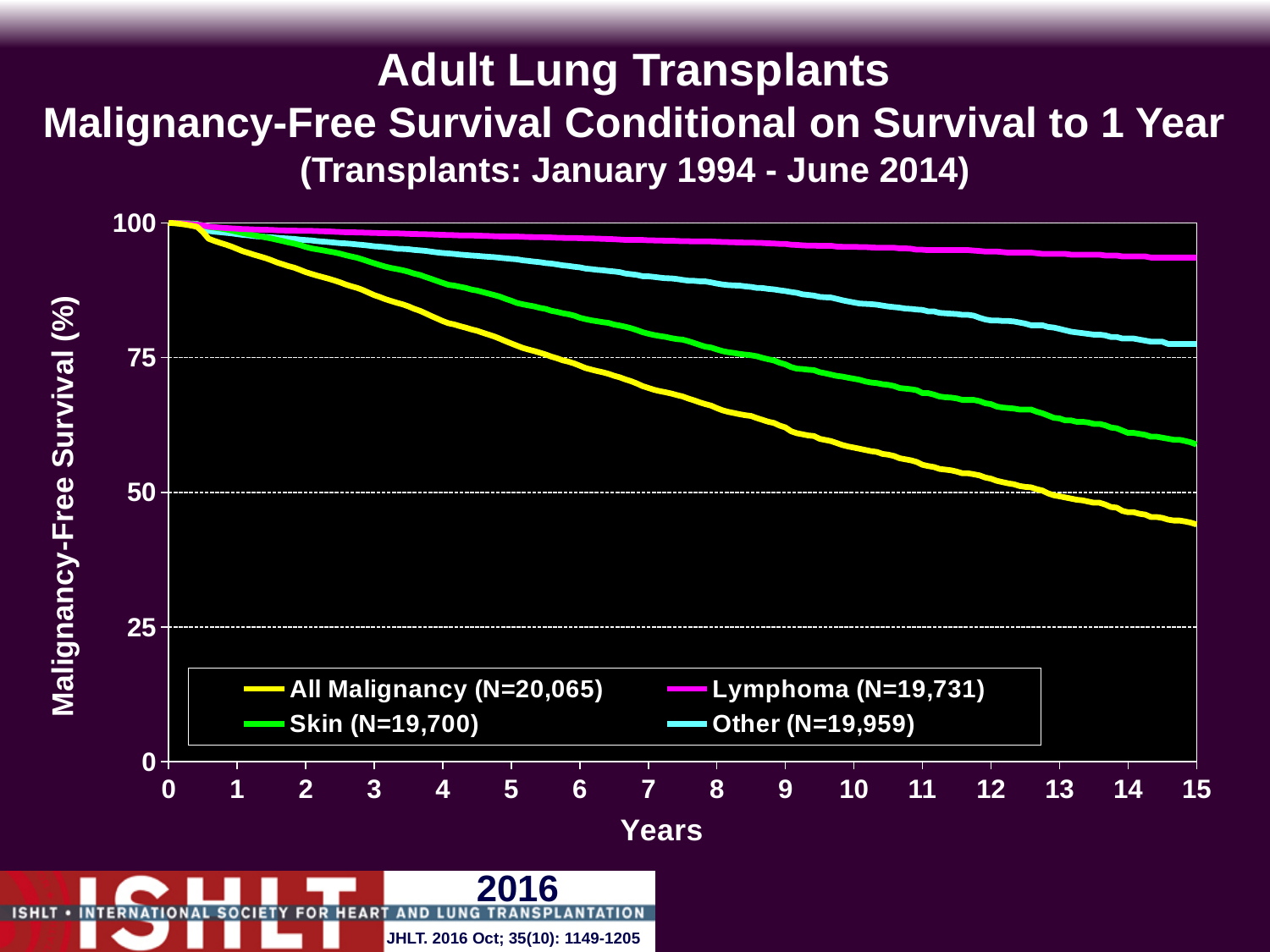
How many series does the legend list? 4 Which series has the lowest malignancy-free survival at 15 years? All Malignancy What colour is the All Malignancy line? yellow Is the value for Lymphoma at 15 years greater or less than 75? greater Which series has the highest malignancy-free survival at 15 years? Lymphoma What is the N shown in the legend for the Lymphoma series? 19,731 Does the All Malignancy curve rise or fall as years increase? fall Is the value for Other at 15 years greater or less than 75? greater Is the value for Skin at 15 years greater or less than 50? greater At 10 years, which is higher: the Skin curve or the Other curve? Other What kind of chart is shown on the slide? line chart